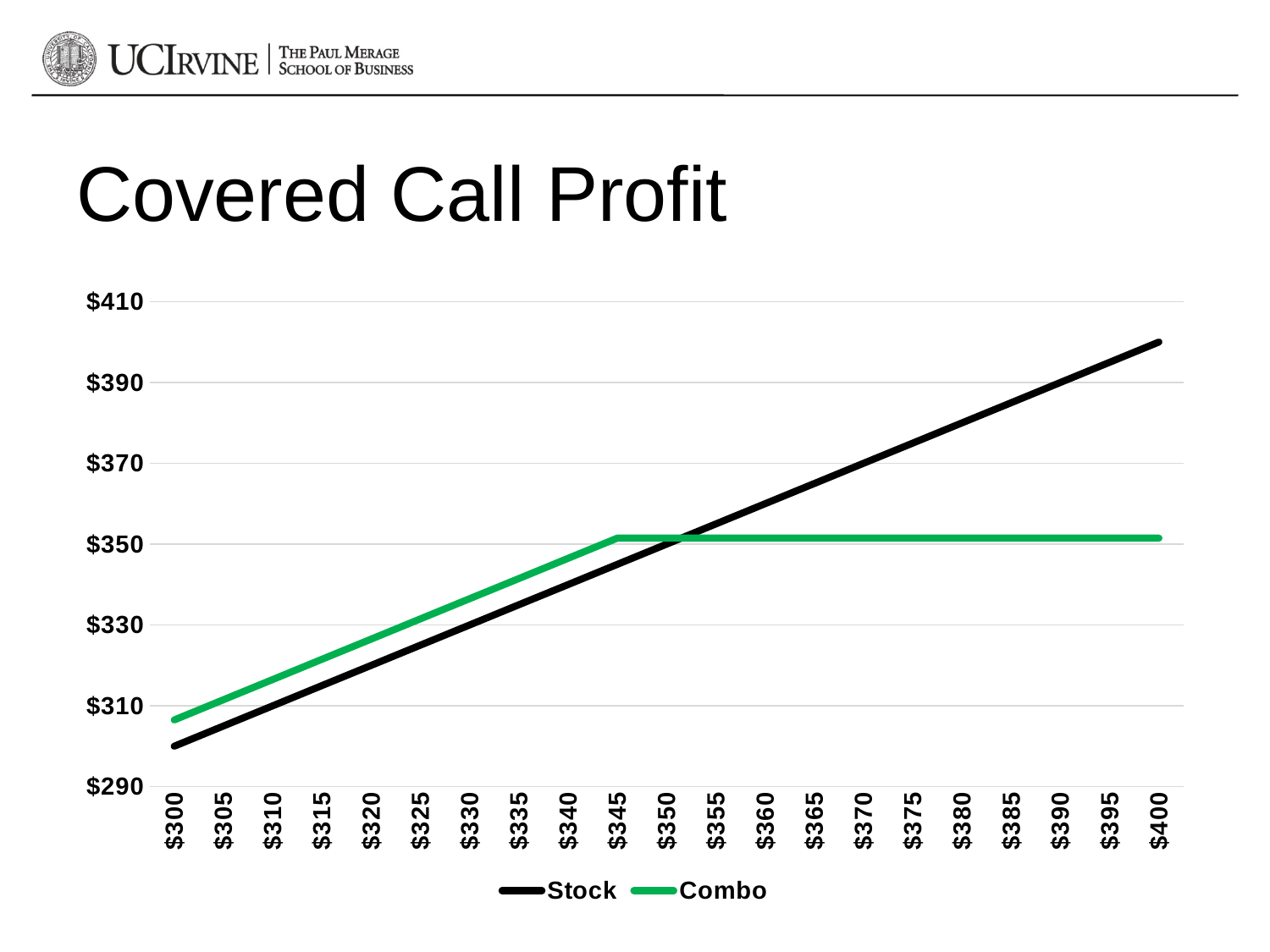
Is the value of the Combo series at $400 greater or less than $370? less At $400, which series has the higher value, Stock or Combo? Stock What is the title of the chart? Covered Call Profit Is the value of the Stock series at $300 greater or less than $310? less At $300, which series has the higher value, Stock or Combo? Combo Which series is drawn in green? Combo How many series does the legend list? 2 Does the Stock series rise or fall as the x-axis price increases from $300 to $400? rise How many price points are labelled along the x axis? 21 Is the value of the Stock series at $400 greater or less than $390? greater What kind of chart is shown on the slide? line chart